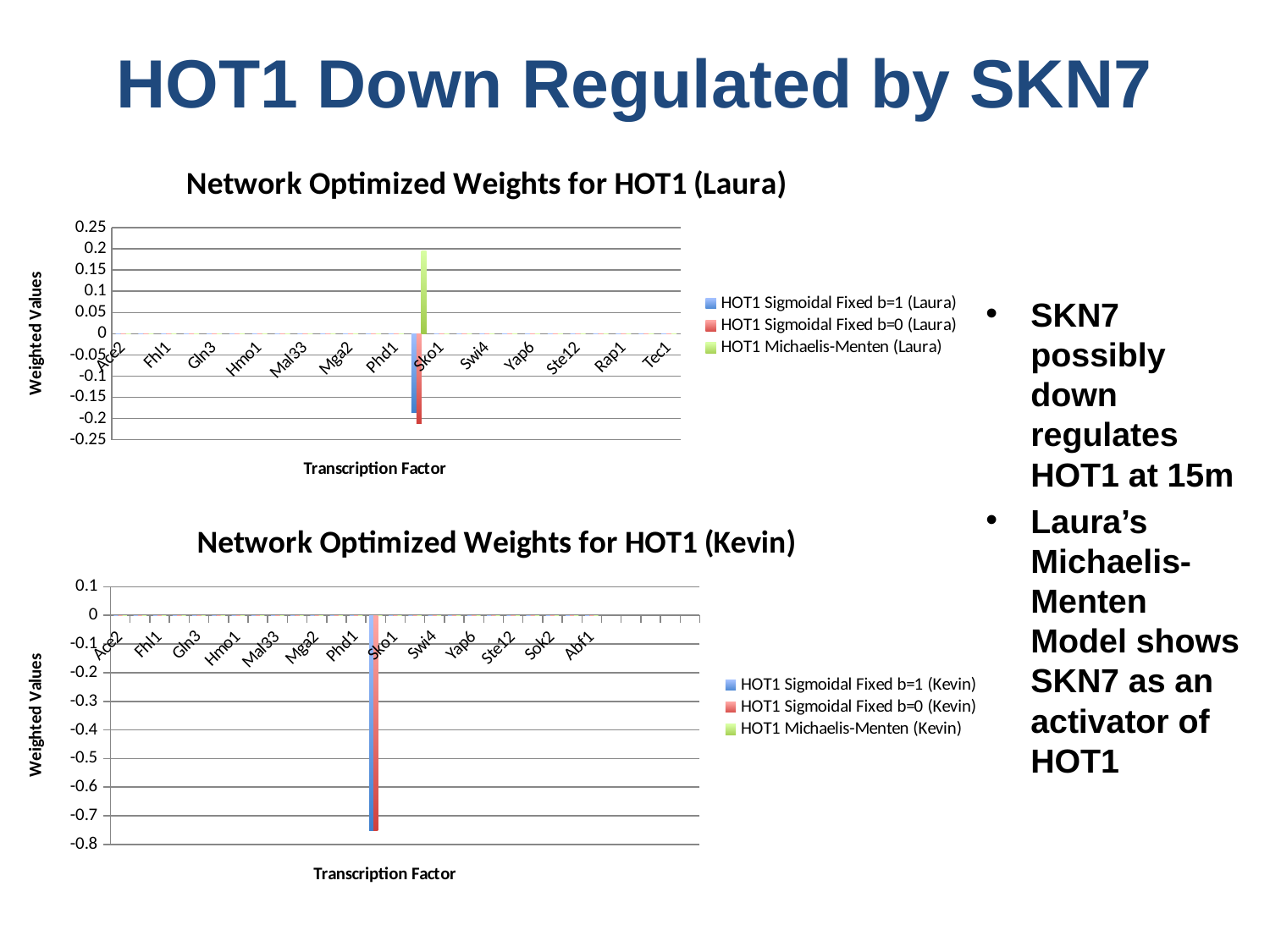
In the "Network Optimized Weights for HOT1 (Kevin)" chart, is the lowest value of the HOT1 Sigmoidal Fixed b=0 (Kevin) series greater or less than -0.5? less What is the title of the x axis on the "Network Optimized Weights for HOT1 (Kevin)" chart? Transcription Factor In the "Network Optimized Weights for HOT1 (Laura)" chart, is the highest value of the HOT1 Michaelis-Menten (Laura) series greater or less than 0.15? greater In the "Network Optimized Weights for HOT1 (Laura)" chart, is the lowest value of the HOT1 Sigmoidal Fixed b=1 (Laura) series greater or less than -0.15? less In the "Network Optimized Weights for HOT1 (Laura)" chart, which series has a bar that extends above zero? HOT1 Michaelis-Menten (Laura) What kind of chart is "Network Optimized Weights for HOT1 (Laura)"? bar chart How many series does the legend of the "Network Optimized Weights for HOT1 (Laura)" chart list? 3 How many series does the legend of the "Network Optimized Weights for HOT1 (Kevin)" chart list? 3 What is the title of the y axis on the "Network Optimized Weights for HOT1 (Laura)" chart? Weighted Values What kind of chart is "Network Optimized Weights for HOT1 (Kevin)"? bar chart